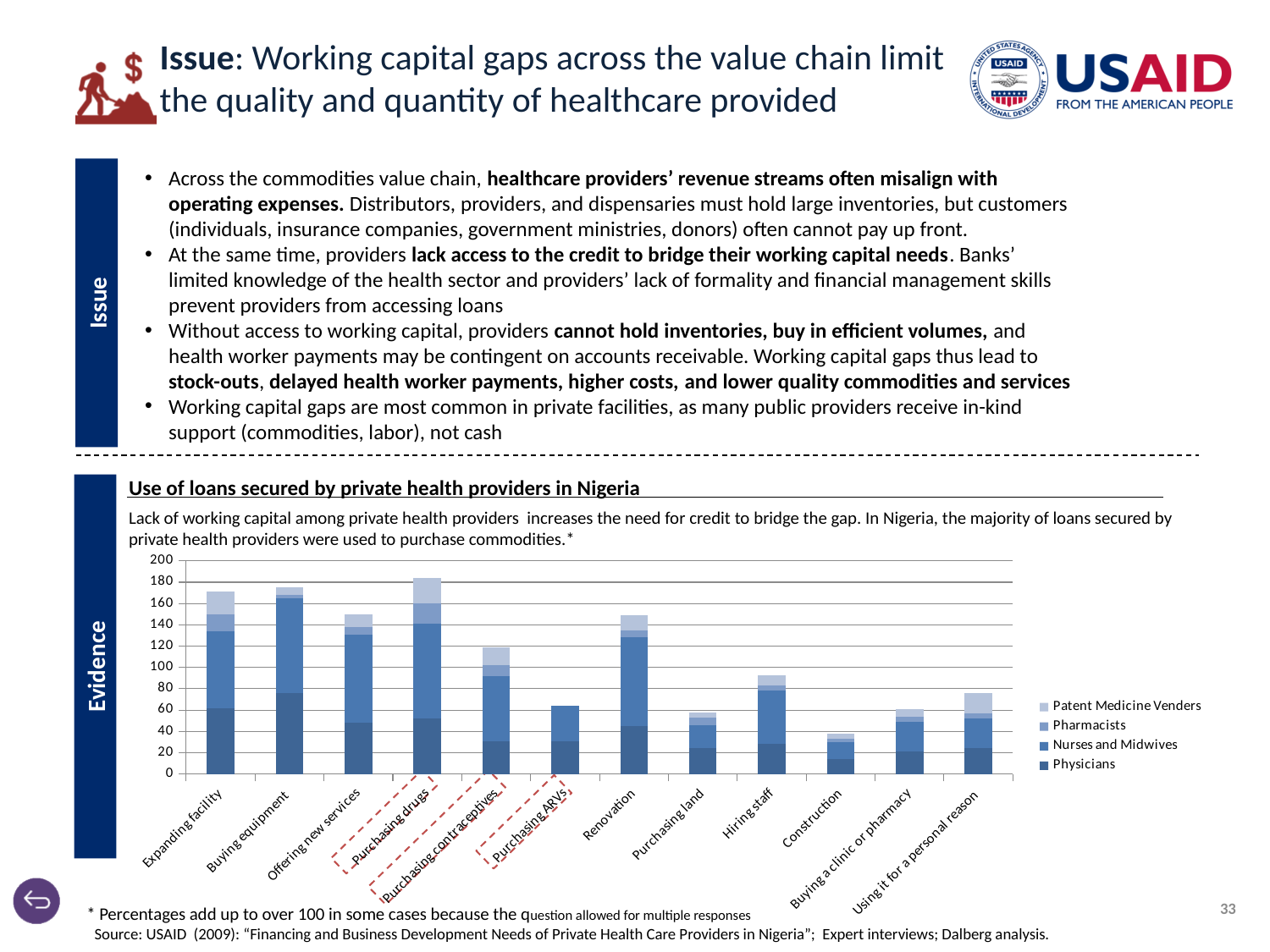
Which has the larger total bar, Expanding facility or Purchasing contraceptives? Expanding facility Which series is shown at the bottom of each stacked bar, according to the legend? Physicians Is the total bar for Purchasing drugs greater or less than 160? greater Is the total bar for Purchasing contraceptives greater or less than 100? greater Which has the larger total bar, Renovation or Purchasing land? Renovation How many series does the chart's legend list? 4 What kind of chart is shown under 'Use of loans secured by private health providers in Nigeria'? Stacked bar chart Which legend entry is shown in the lightest blue colour? Patent Medicine Venders Which category has the lowest total bar in the chart? Construction Is the total bar for Purchasing ARVs greater or less than 80? less How many loan-use categories are shown on the x axis of the chart? 12